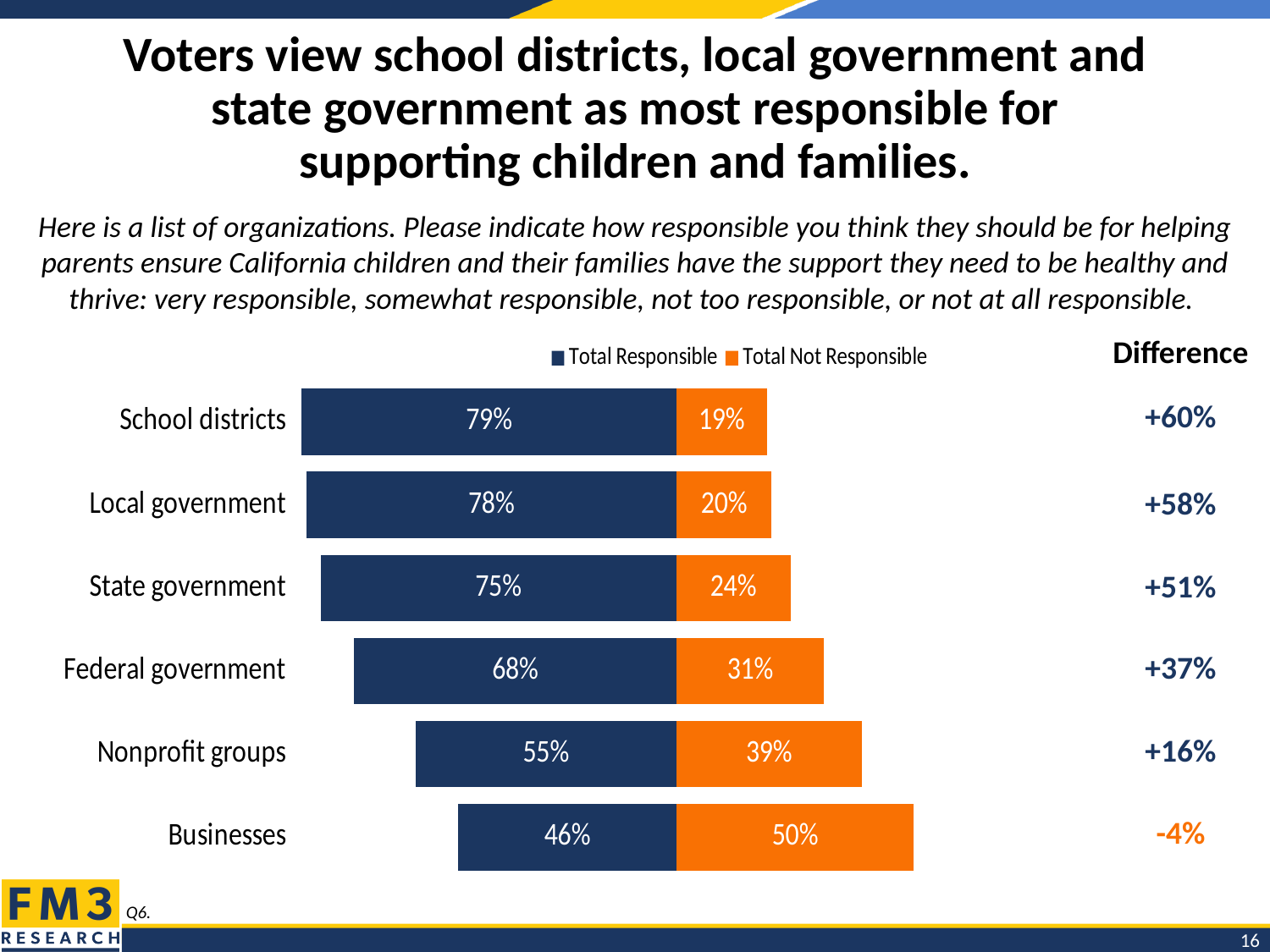
Which category has the highest Total Responsible value? School districts What is the Total Not Responsible value for Federal government? 31% What is the Total Not Responsible value for Businesses? 50% What is the Total Responsible value for School districts? 79% What kind of chart is shown on the slide? Bar chart What is the difference between the Total Responsible values for State government and Nonprofit groups? 20% Which has a larger Total Not Responsible value, Nonprofit groups or Local government? Nonprofit groups Which category has the lowest Total Responsible value? Businesses What is the Difference value shown for Federal government? +37% Which series is shown in orange in the legend? Total Not Responsible How many series does the legend list? 2 How many categories are shown in the chart? 6